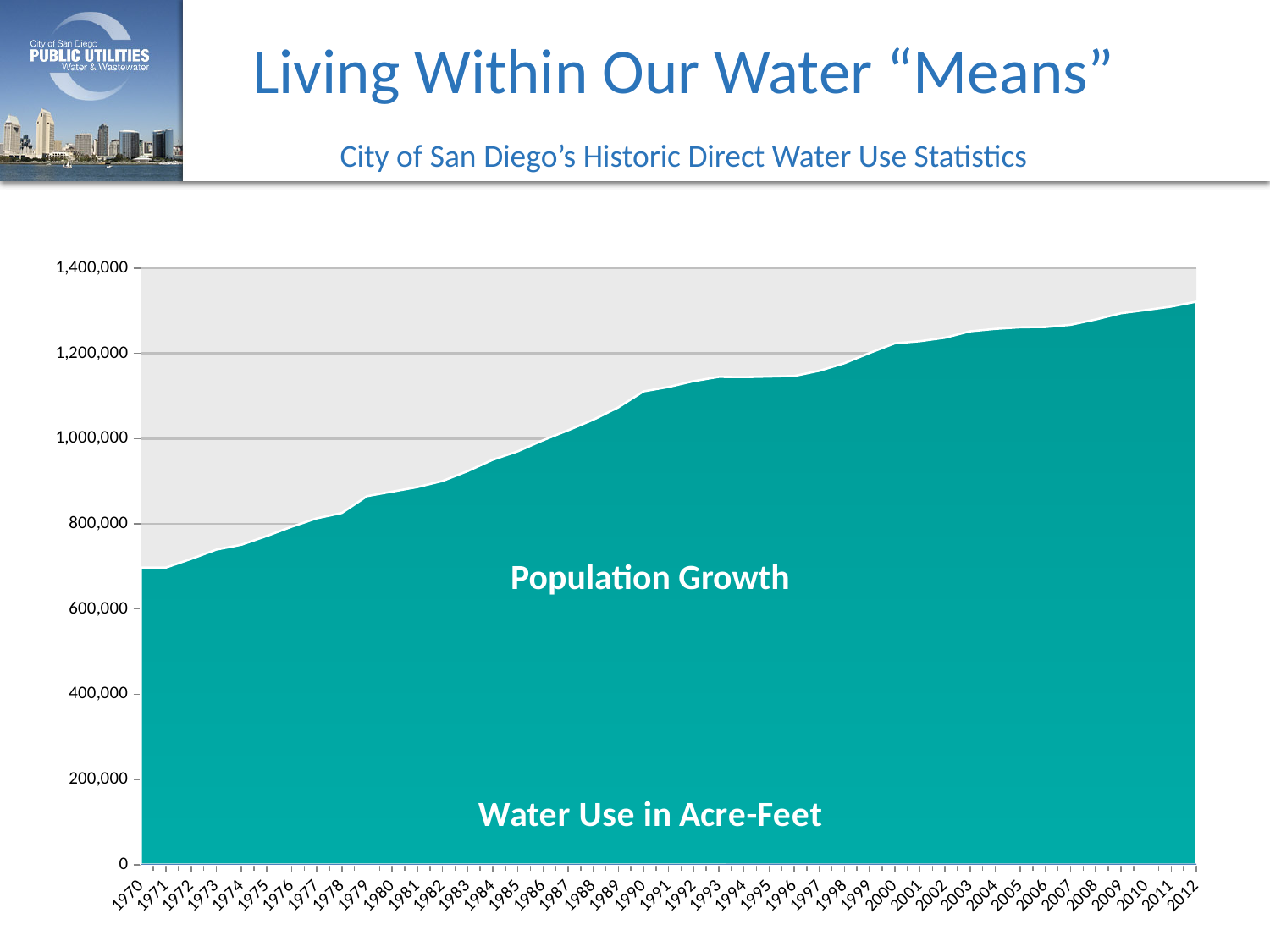
Is the value for 2012 greater or less than 1,200,000? greater Is the value for 1990 greater or less than 1,000,000? greater Is the value for 1980 greater or less than 800,000? greater What is the highest value shown on the y axis? 1,400,000 Which is larger, the value for 2000 or the value for 1980? 2000 Which year has the highest value on the chart? 2012 What kind of chart is shown on the slide? Area chart Do the values rise or fall from 1970 to 2012? Rise How many years are plotted along the x axis? 43